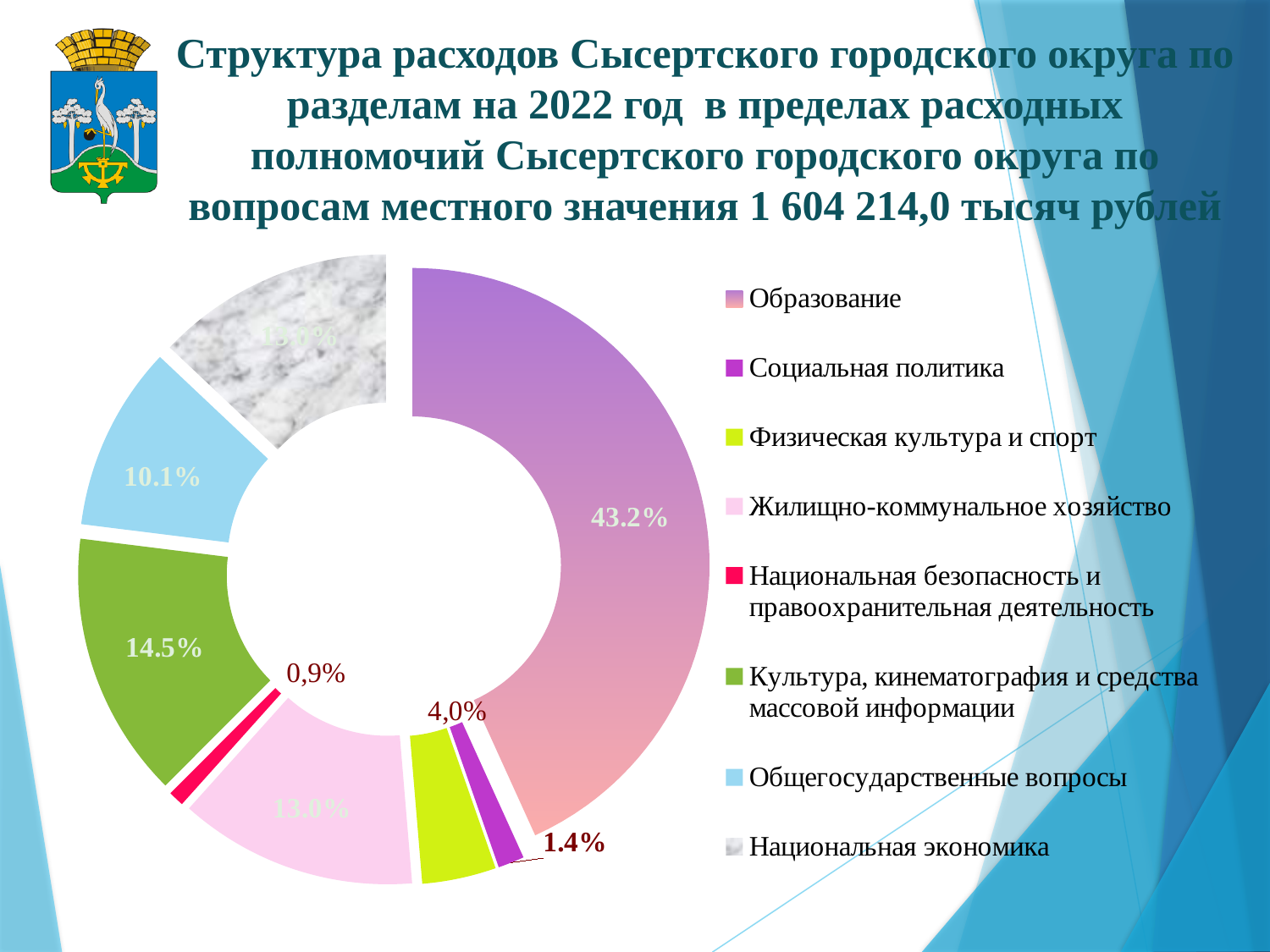
What share of expenditures goes to Общегосударственные вопросы? 10.1% Which section has the largest share of expenditures? Образование What share of expenditures goes to Социальная политика? 1.4% How many sections does the legend list? 8 What share of expenditures goes to Образование? 43.2% What share of expenditures goes to Физическая культура и спорт? 4,0% Which section has the smallest share of expenditures? Национальная безопасность и правоохранительная деятельность What share of expenditures goes to Культура, кинематография и средства массовой информации? 14.5% What is the difference between the shares of Культура, кинематография и средства массовой информации and Общегосударственные вопросы? 4.4% What share of expenditures goes to Национальная безопасность и правоохранительная деятельность? 0,9% What kind of chart is shown on the slide? Doughnut (pie) chart What share of expenditures goes to Жилищно-коммунальное хозяйство? 13.0%